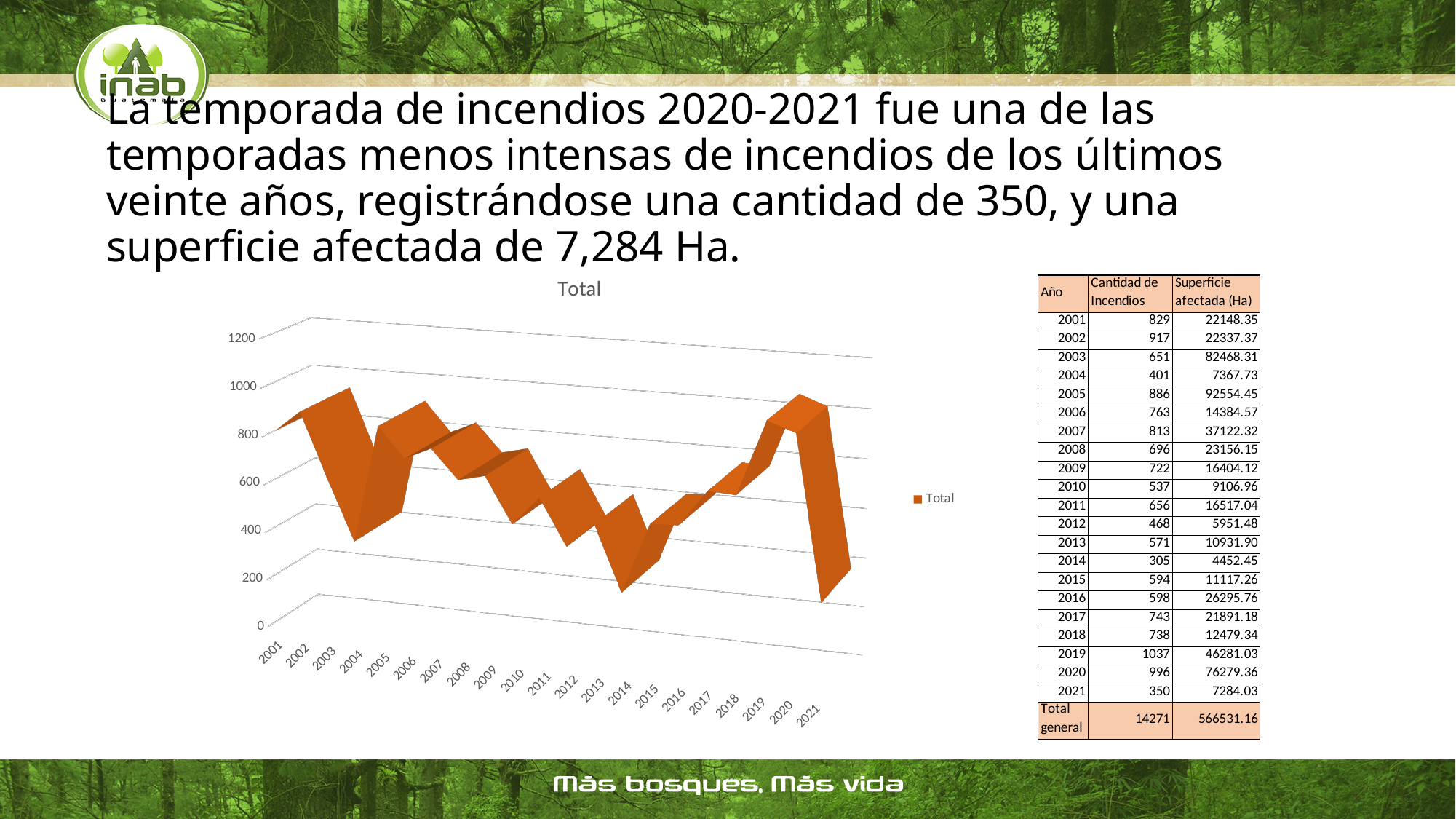
Do the values in the chart rise or fall from 2019 to 2021? fall Using the values in the table, what is the difference in Cantidad de Incendios between 2019 and 2021? 687 Which year has the highest value in the chart? 2019 According to the table, what is the Cantidad de Incendios for 2019? 1037 Is the value for 2019 in the chart greater or less than 1000? greater Which year has the lowest value in the chart? 2014 How many years are plotted along the x axis of the chart? 21 How many series does the chart legend list? 1 Is the value for 2021 in the chart greater or less than 400? less Is the value for 2014 in the chart greater or less than 400? less What is the title of the chart? Total Which year has the larger value in the chart, 2003 or 2004? 2003